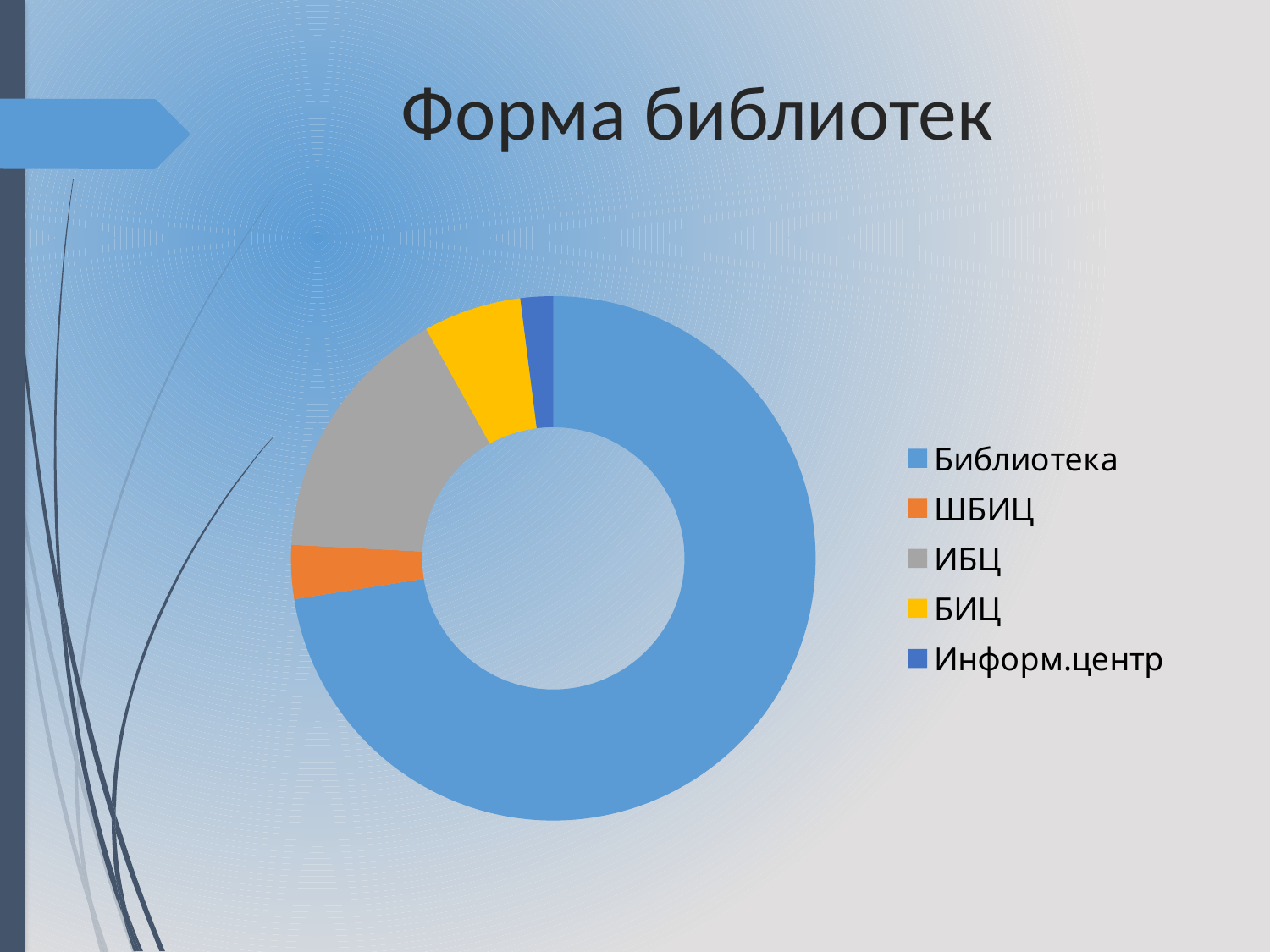
Which category is shown in yellow? БИЦ How many categories does the chart show? 5 Which is larger, the share for Библиотека or the share for ИБЦ? Библиотека Which is larger, the share for ИБЦ or the share for БИЦ? ИБЦ Does Библиотека account for more or less than half of the chart? More than half What type of chart is shown on the slide? Doughnut (pie) chart Which is larger, the share for БИЦ or the share for Информ.центр? БИЦ What colour represents ШБИЦ in the chart? Orange Which category has the largest share of the chart? Библиотека Which category has the second largest share of the chart? ИБЦ What is the title of the chart? Форма библиотек